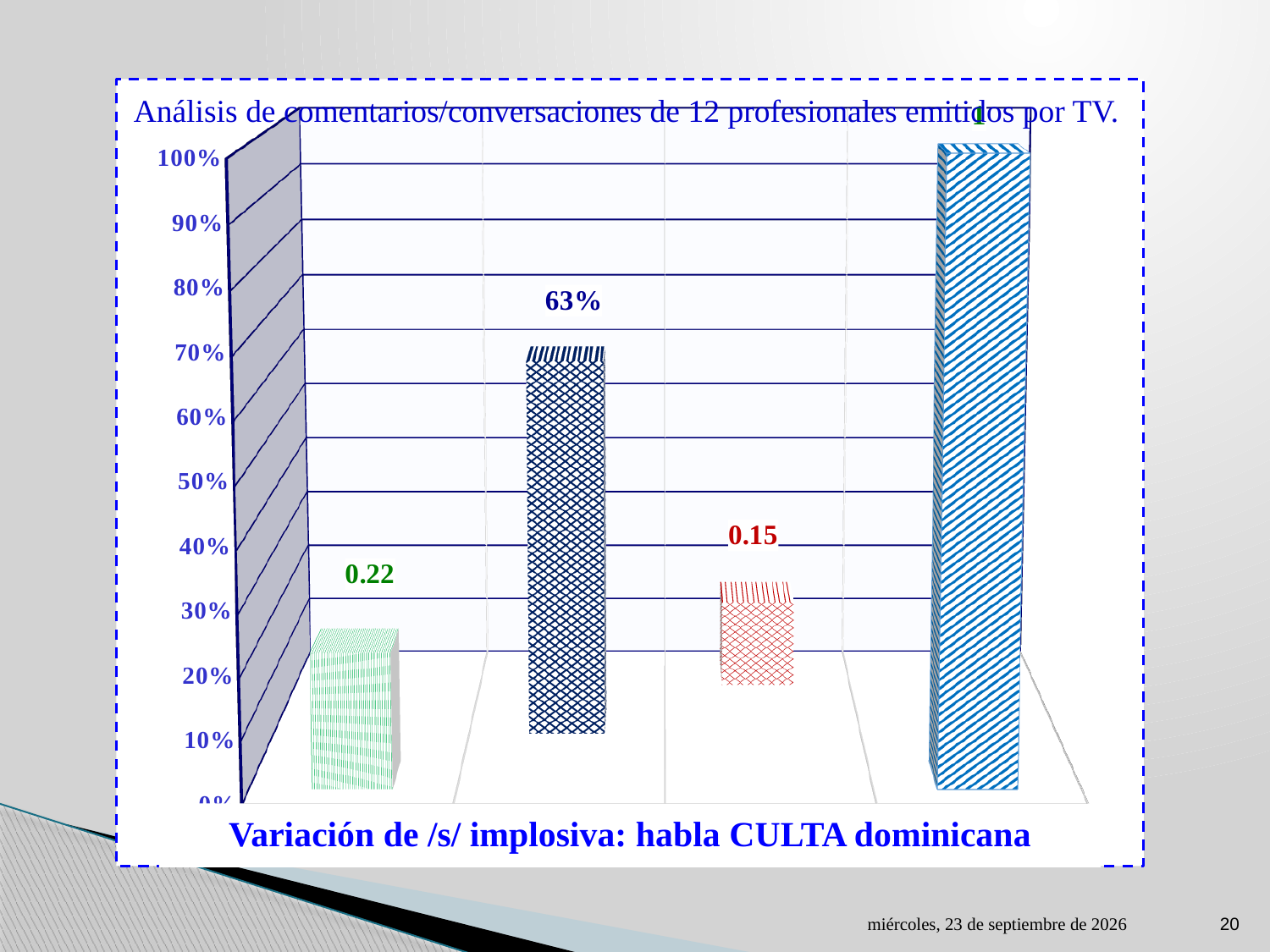
What is the title shown at the top of the chart? Análisis de comentarios/conversaciones de 12 profesionales emitidos por TV. What value is labelled on the tallest bar, the rightmost blue striped bar? 1 Which bar is the shortest in the chart? the third bar (red) Is the value of the red (third) bar greater or less than 50%? less What value is labelled on the first bar from the left (the green bar)? 0.22 Which bar is the tallest in the chart? the rightmost (fourth) bar What value is labelled on the second bar from the left (the dark blue cross-hatched bar)? 63% How many bars are plotted in the chart? 4 Which is larger, the value of the first bar (0.22) or the third bar (0.15)? the first bar (0.22) What value is labelled on the third bar from the left (the red bar)? 0.15 What is the difference between the value of the first bar and the value of the third bar? 0.07 What kind of chart is shown on the slide? bar chart